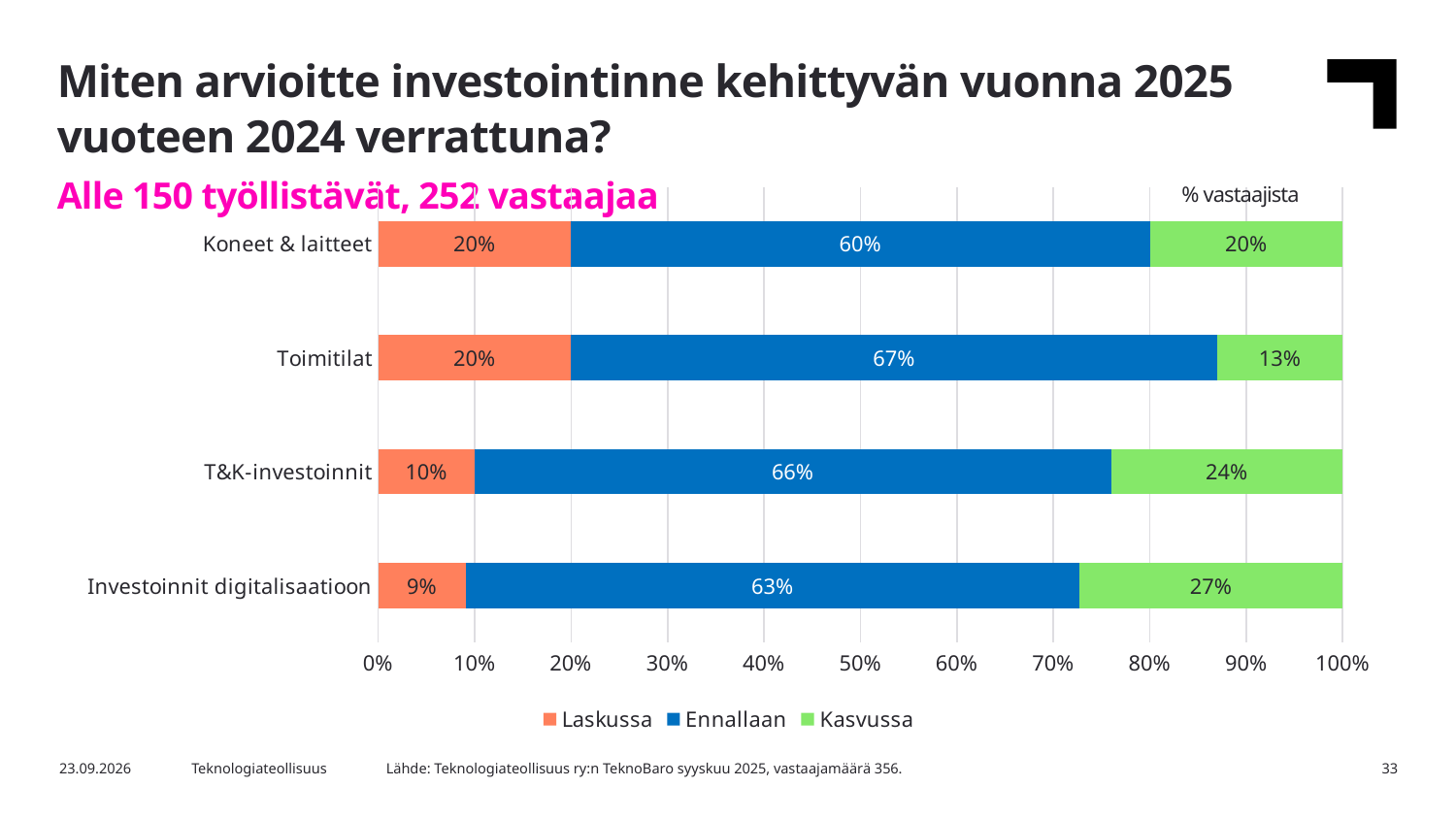
What is the Kasvussa value for Toimitilat? 13% What is the Laskussa value for T&K-investoinnit? 10% How many series does the legend list? 3 How many categories are shown on the chart? 4 Which category has the highest Kasvussa share? Investoinnit digitalisaatioon What is the Kasvussa value for Investoinnit digitalisaatioon? 27% What percentage of respondents expect Koneet & laitteet investments to be Ennallaan? 60% Which category has the highest Ennallaan share? Toimitilat Is the Laskussa value larger for Koneet & laitteet or for Investoinnit digitalisaatioon? Koneet & laitteet Which category has the lowest Kasvussa share? Toimitilat What type of chart is shown on the slide? Stacked bar chart What is the difference between the Kasvussa values for T&K-investoinnit and Toimitilat? 11 percentage points